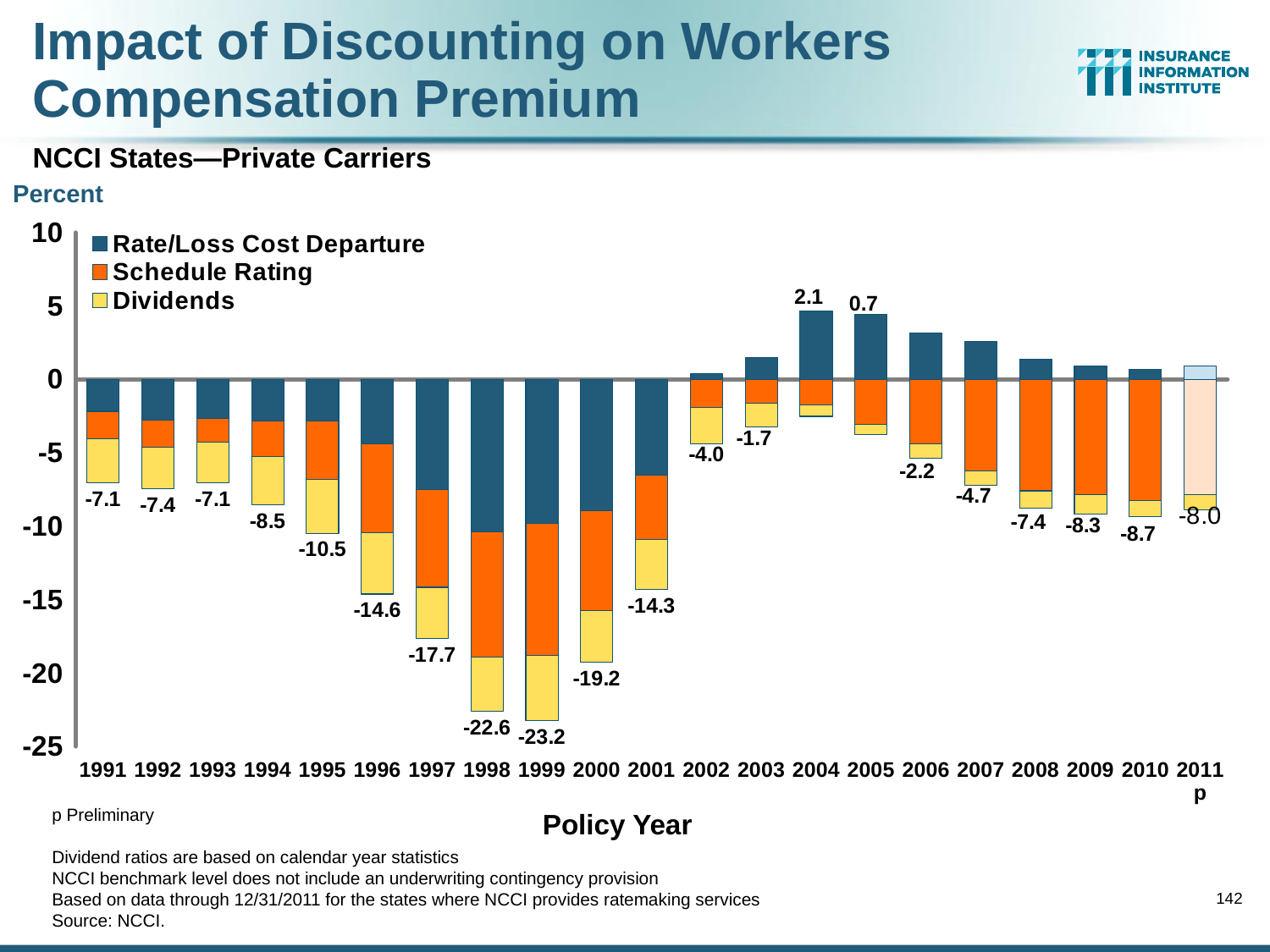
Which policy year has the lowest labeled net value? 1999 How many policy years are shown on the x axis? 21 What is the difference between the labeled net values for 1998 and 1999? 0.6 Which series is shown in yellow in the legend? Dividends What is the labeled net value for policy year 2004? 2.1 How many series does the legend list? 3 What is the labeled net value for policy year 2011p? -8.0 What kind of chart is shown on the slide? Stacked bar chart Which policy year has the highest labeled net value? 2004 Which policy year has a larger labeled net value, 2002 or 2003? 2003 What is the labeled net value for policy year 1999? -23.2 What is the difference between the labeled net values for 2009 and 2010? 0.4